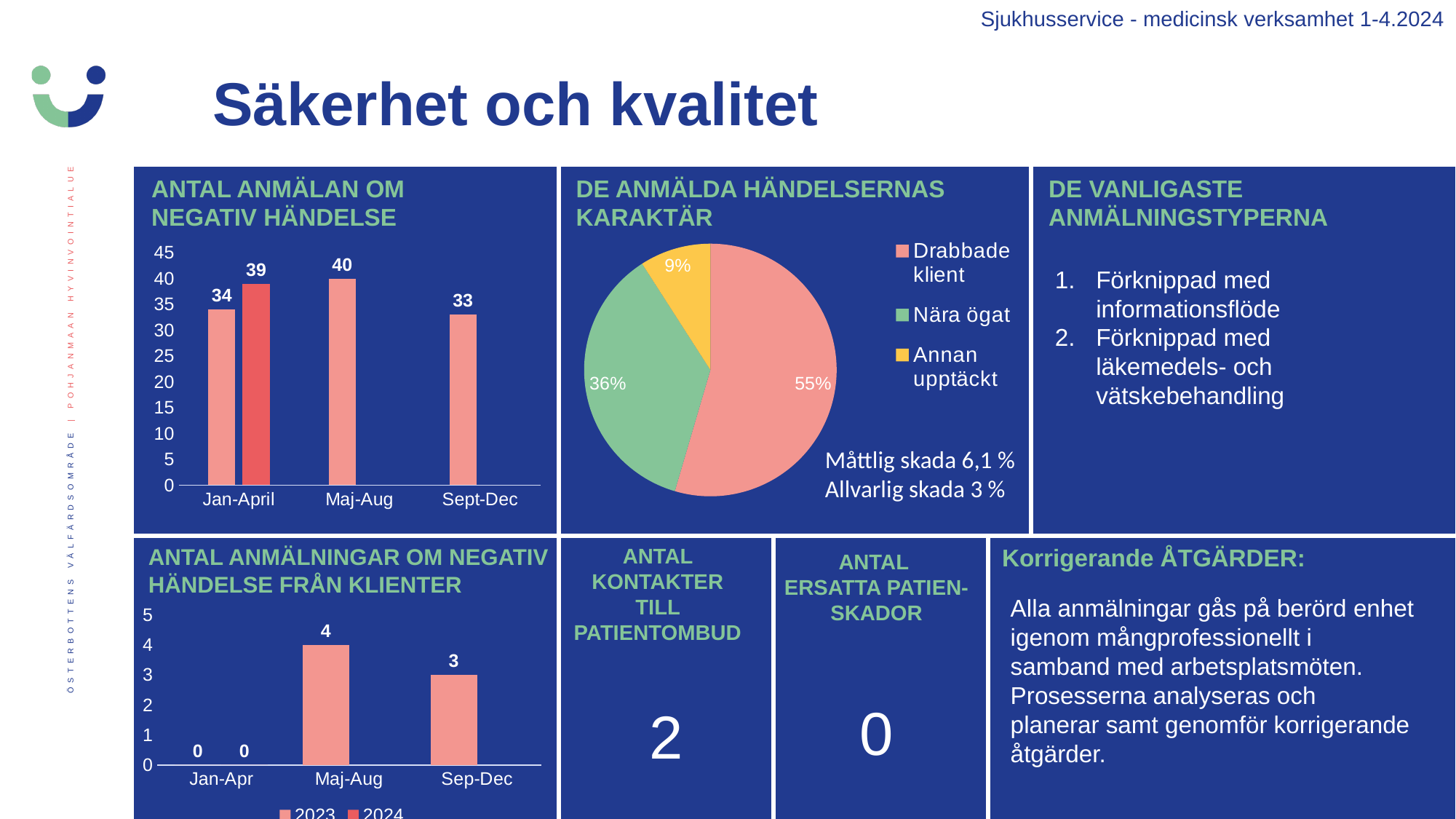
In the pie chart 'DE ANMÄLDA HÄNDELSERNAS KARAKTÄR', how many categories does the legend list? 3 In the chart 'ANTAL ANMÄLAN OM NEGATIV HÄNDELSE', what is the value of the bar for Maj-Aug? 40 In the chart 'ANTAL ANMÄLAN OM NEGATIV HÄNDELSE', which period has the highest bar? Maj-Aug In the chart 'ANTAL ANMÄLAN OM NEGATIV HÄNDELSE', how many period categories are shown on the x axis? 3 In the chart 'ANTAL ANMÄLNINGAR OM NEGATIV HÄNDELSE FRÅN KLIENTER', which two series does the legend list? 2023 and 2024 In the pie chart 'DE ANMÄLDA HÄNDELSERNAS KARAKTÄR', which category has the largest slice? Drabbade klient In the pie chart 'DE ANMÄLDA HÄNDELSERNAS KARAKTÄR', which category has the smallest slice? Annan upptäckt In the chart 'ANTAL ANMÄLAN OM NEGATIV HÄNDELSE', what are the two values shown for Jan-April? 34 and 39 In the pie chart 'DE ANMÄLDA HÄNDELSERNAS KARAKTÄR', what share is 'Nära ögat'? 36% In the chart 'ANTAL ANMÄLNINGAR OM NEGATIV HÄNDELSE FRÅN KLIENTER', what is the value for Maj-Aug? 4 In the chart 'ANTAL ANMÄLAN OM NEGATIV HÄNDELSE', what is the difference between the two Jan-April bars (39 and 34)? 5 In the chart 'ANTAL ANMÄLAN OM NEGATIV HÄNDELSE', what is the value of the bar for Sept-Dec? 33